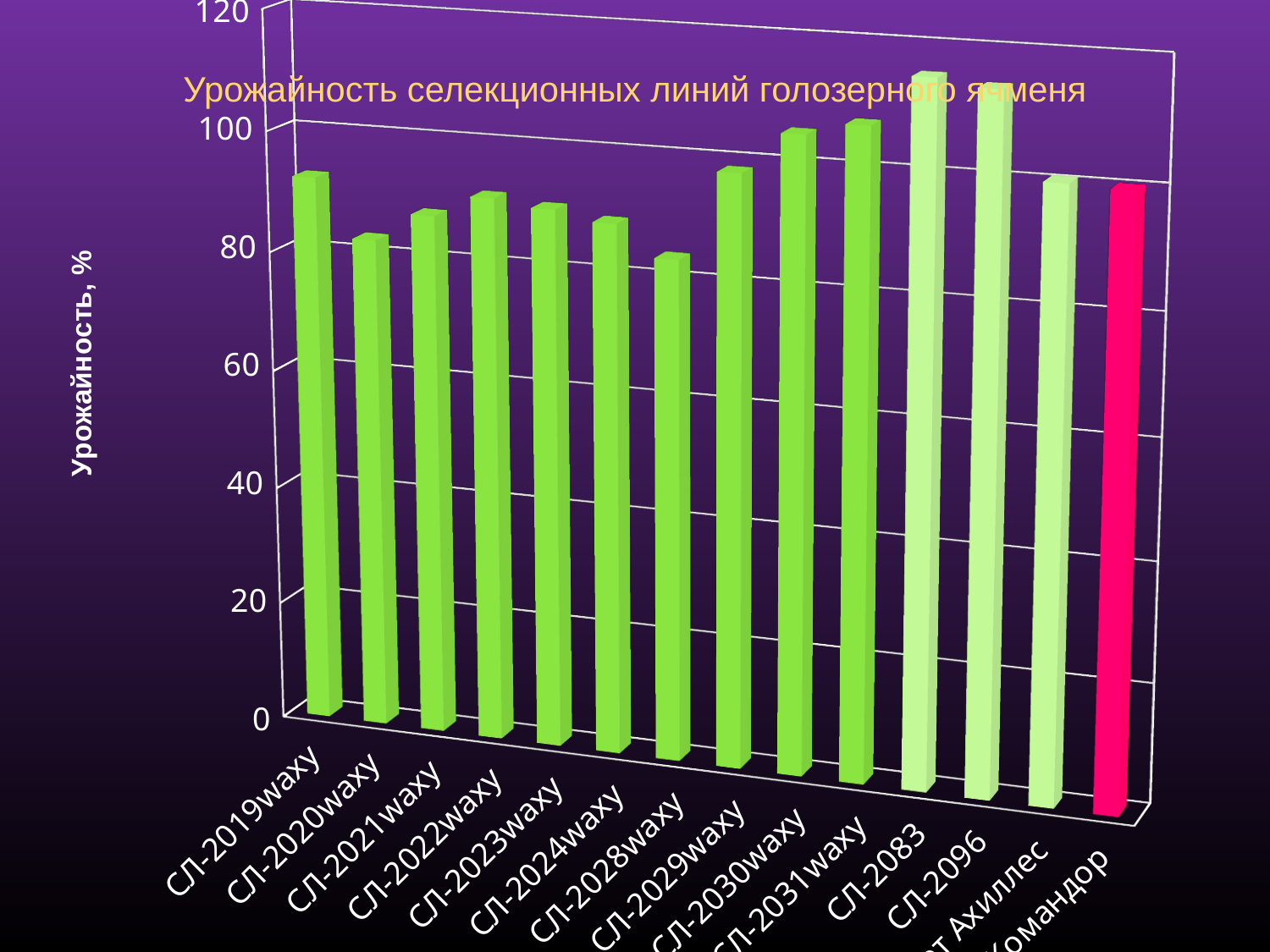
Is the value for СЛ-2083 greater or less than 100? greater How many bars (categories) are plotted in the chart? 14 Is the value for СЛ-2031waxy greater or less than 80? greater What is the label of the vertical axis? Урожайность, % What kind of chart is shown on the slide? bar chart Which has the larger value, СЛ-2030waxy or СЛ-2024waxy? СЛ-2030waxy Is the value for СЛ-2020waxy greater or less than 60? greater Which has the larger value, СЛ-2029waxy or СЛ-2028waxy? СЛ-2029waxy What is the title of the chart? Урожайность селекционных линий голозерного ячменя Which has the larger value, СЛ-2083 or СЛ-2028waxy? СЛ-2083